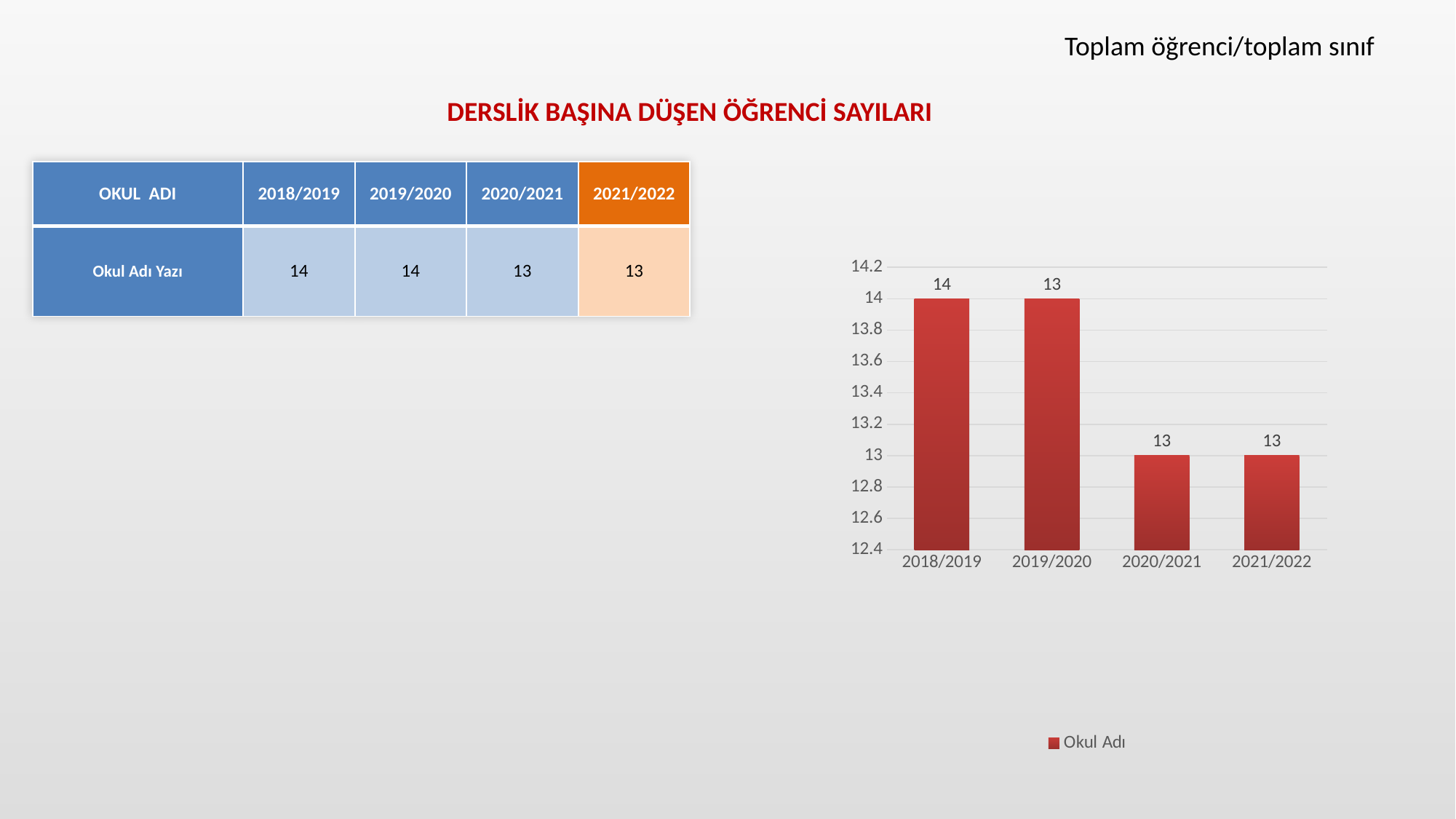
How many categories are shown on the x axis of the chart? 4 Which is larger, the value for 2018/2019 or the value for 2021/2022? 2018/2019 What is the name of the series listed in the chart's legend? Okul Adı What is the value for 2018/2019 in the chart? 14 What kind of chart is shown on the slide? bar chart Do the values in the chart rise or fall from 2018/2019 to 2021/2022? fall Is the value for 2019/2020 greater or less than 13.6? greater What is the value for 2020/2021 in the chart? 13 Is the value for 2020/2021 greater or less than 13.4? less What is the difference between the values for 2018/2019 and 2020/2021? 1 How many series does the chart's legend list? 1 What is the value for 2021/2022 in the chart? 13